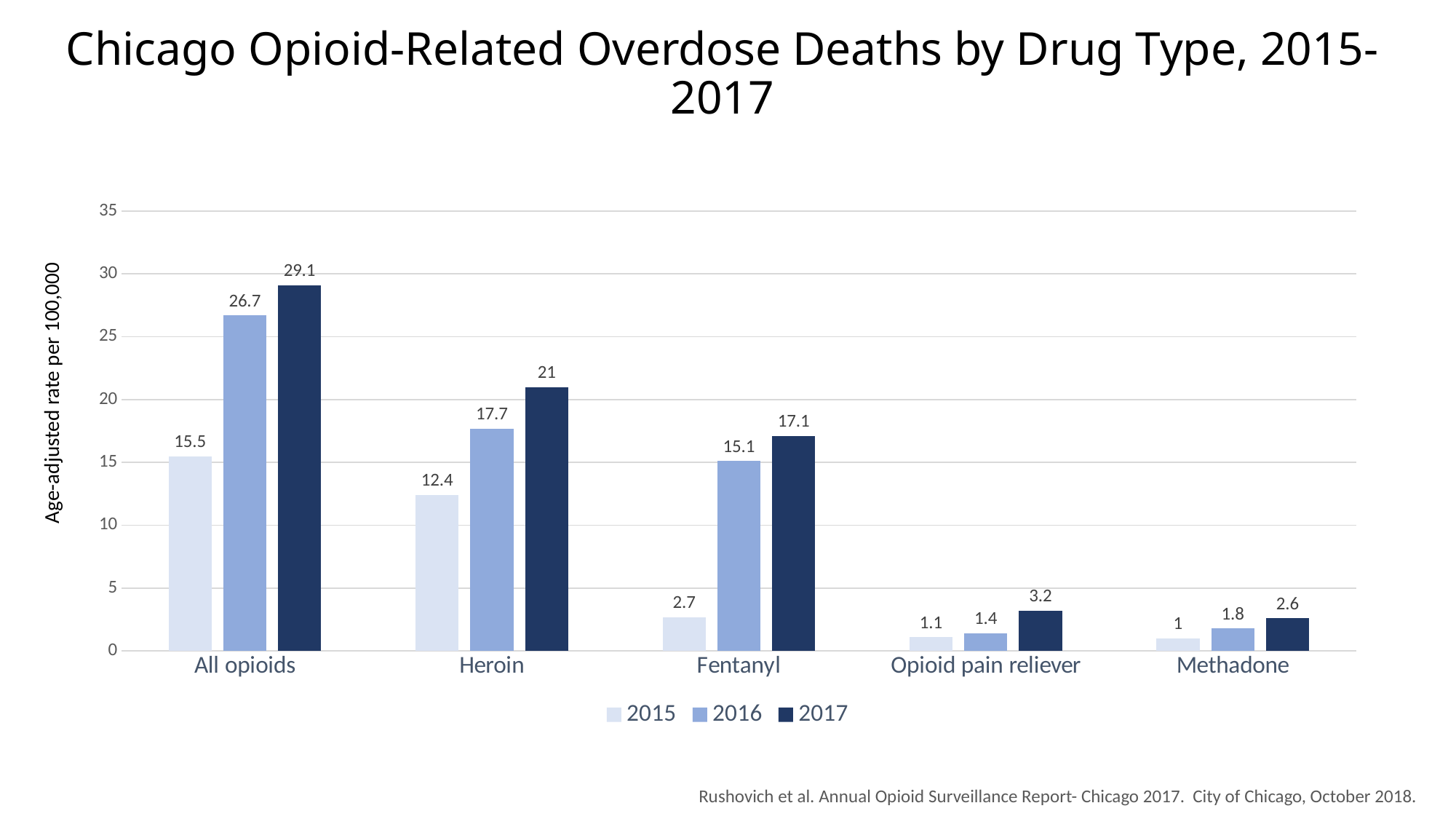
Do the rates for Opioid pain reliever rise or fall from 2015 to 2017? Rise How many drug type categories are shown on the x axis? 5 What is the difference between the 2017 and 2015 rates for All opioids? 13.6 Which drug type has the highest 2017 rate? All opioids What is the age-adjusted rate for Fentanyl in 2015? 2.7 Which drug type has the lowest 2015 rate? Methadone What kind of chart is shown on the slide? Bar chart How many series does the legend list? 3 What is the age-adjusted rate for Heroin in 2017? 21 What is the difference between the 2017 rates for Heroin and Fentanyl? 3.9 What is the age-adjusted rate for Methadone in 2016? 1.8 Which is larger, the 2016 rate for Heroin or the 2017 rate for Fentanyl? 2016 rate for Heroin